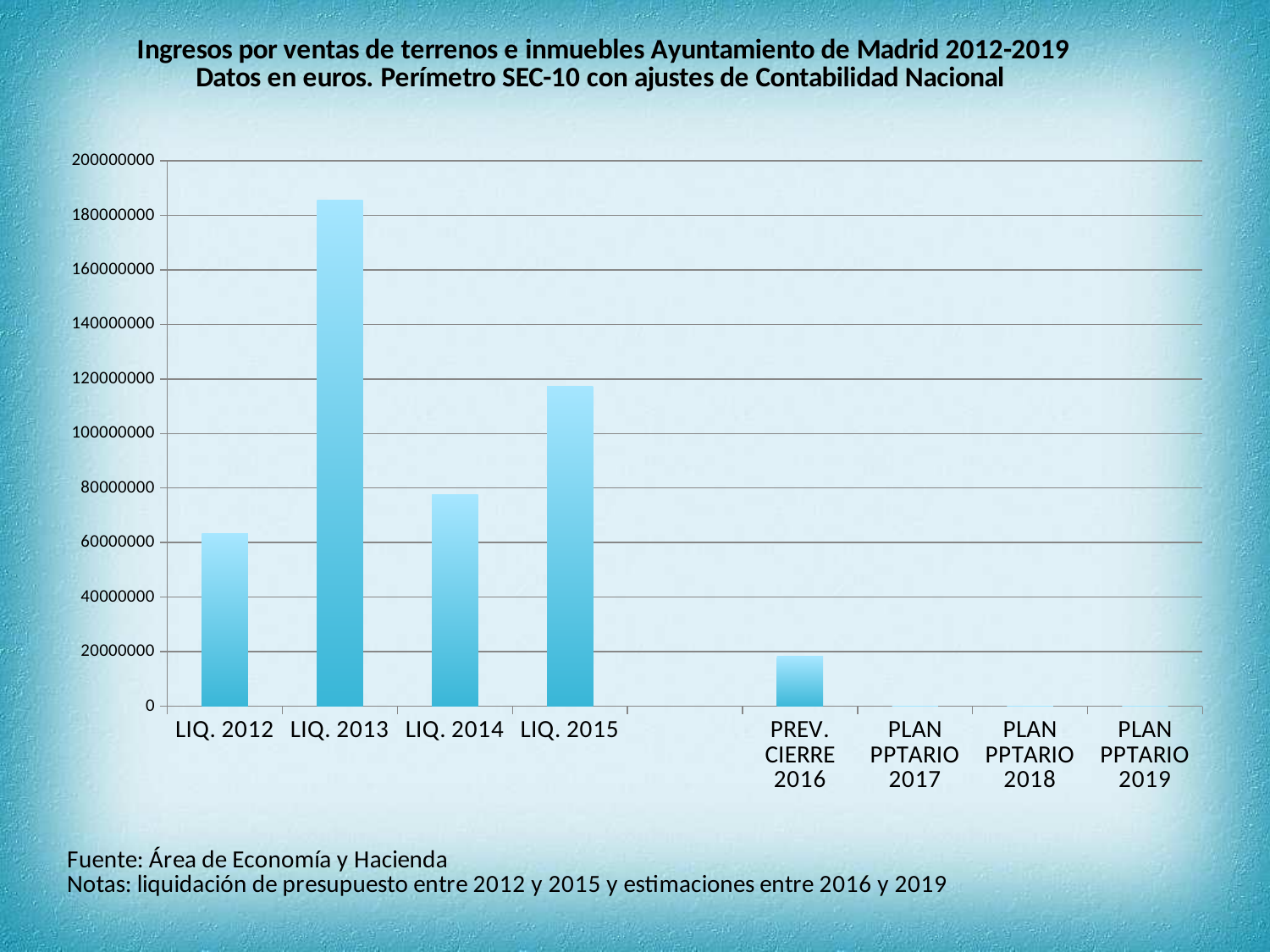
Among the liquidated years LIQ. 2012 to LIQ. 2015, which has the lowest value? LIQ. 2012 Which category has the highest value? LIQ. 2013 Which is larger, the value for LIQ. 2012 or the value for PREV. CIERRE 2016? LIQ. 2012 Is the value for PREV. CIERRE 2016 greater or less than 40000000? less Which is larger, the value for LIQ. 2015 or the value for LIQ. 2014? LIQ. 2015 Is the value for LIQ. 2013 greater or less than 180000000? greater What kind of chart is shown on the slide? bar chart Is the value for LIQ. 2012 greater or less than 80000000? less What is the highest value shown on the vertical axis? 200000000 Do the values rise or fall from LIQ. 2015 to PLAN PPTARIO 2019? fall How many labeled categories are shown on the x axis? 8